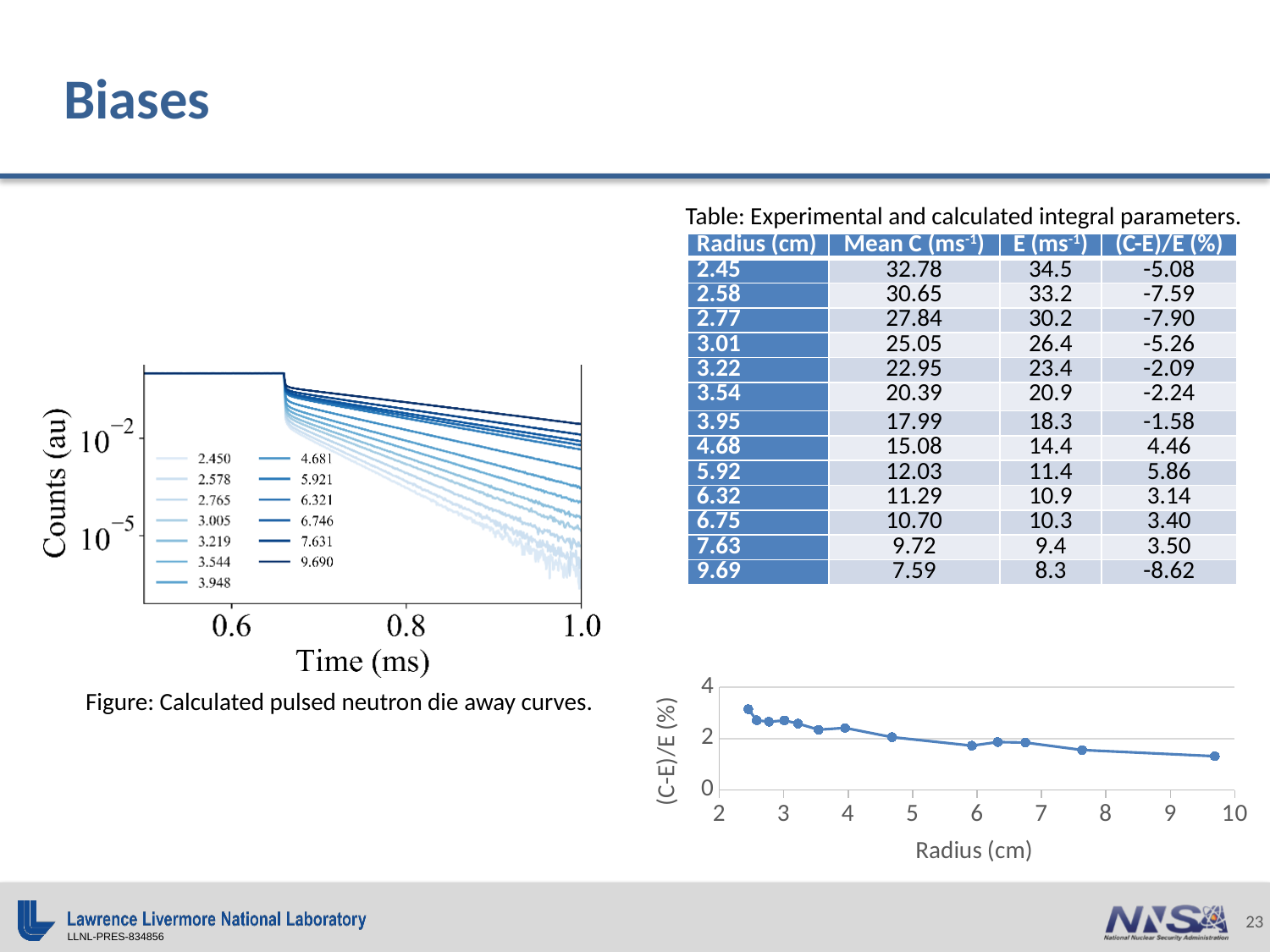
In the bottom-right chart, is the value at the smallest radius (about 2.5 cm) greater or less than 2? greater What kind of chart is the left figure of calculated pulsed neutron die away curves? line chart What kind of chart is the bottom-right chart with Radius (cm) on the x axis? line chart In the bottom-right chart, is the value at a radius of about 6 cm greater or less than 2? less In the bottom-right chart, which point has the highest (C-E)/E value: the one at the smallest radius or the one at the largest radius? the one at the smallest radius In the bottom-right chart, is the value at the largest radius (about 9.7 cm) greater or less than 2? less In the bottom-right chart, do the (C-E)/E values rise or fall as the radius increases? fall What is the x-axis label of the left chart? Time (ms) In the bottom-right chart, how many data points are plotted? 13 What is the y-axis label of the bottom-right chart? (C-E)/E (%) In the left chart, do the counts rise or fall with time after about 0.65 ms? fall How many series does the legend of the left chart (pulsed neutron die away curves) list? 13